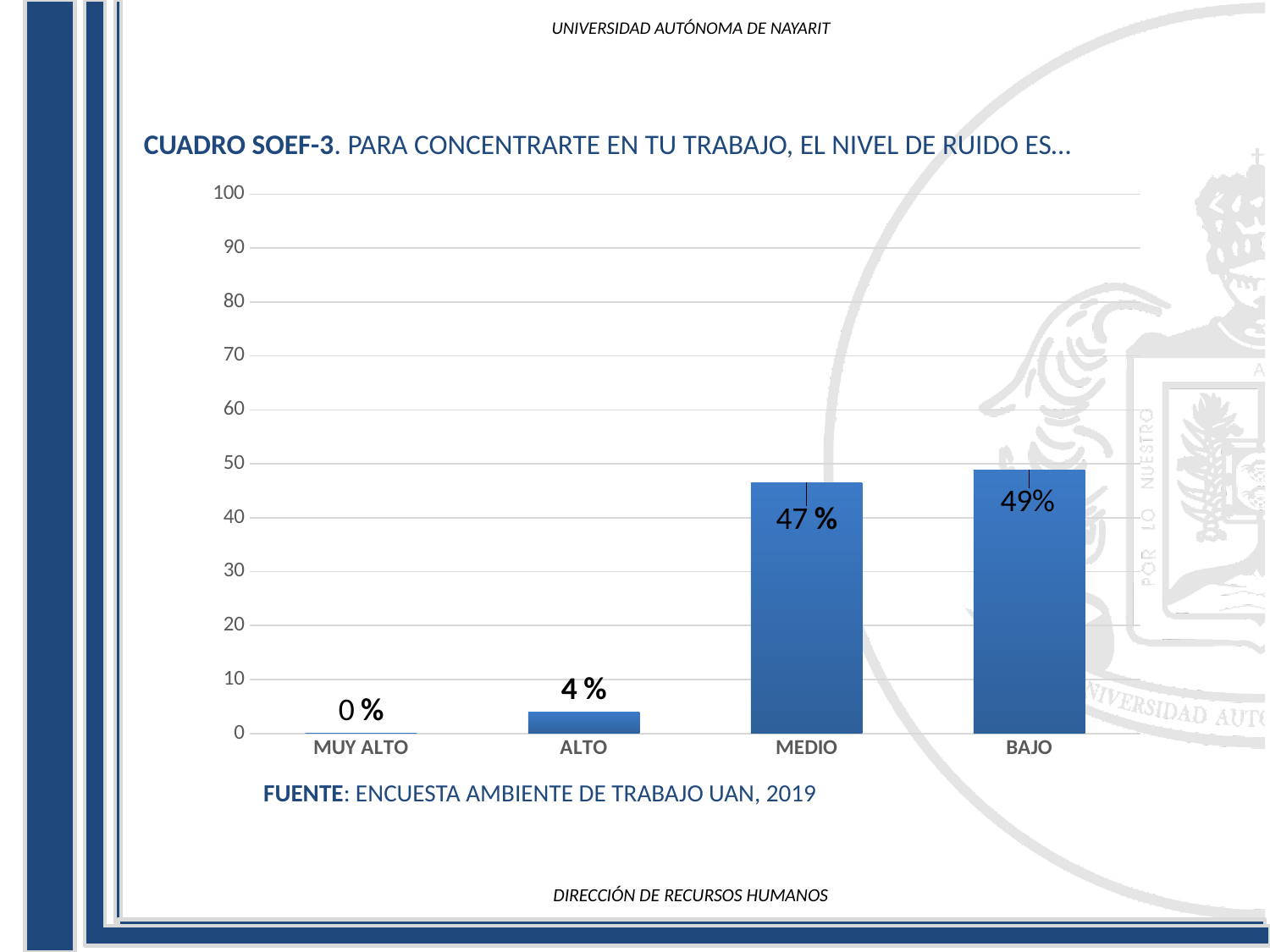
How many categories are shown on the x axis? 4 Which is larger, the value for ALTO or the value for MEDIO? MEDIO Which category has the lowest value? MUY ALTO What is the value for MEDIO? 47 % What kind of chart is shown on the slide? bar chart What is the value for BAJO? 49% What is the value for MUY ALTO? 0 % What is the value for ALTO? 4 % Which category has the highest value? BAJO What is the difference between the values for BAJO and MEDIO? 2 Is the value for BAJO greater or less than 40? greater What is the difference between the values for MEDIO and ALTO? 43